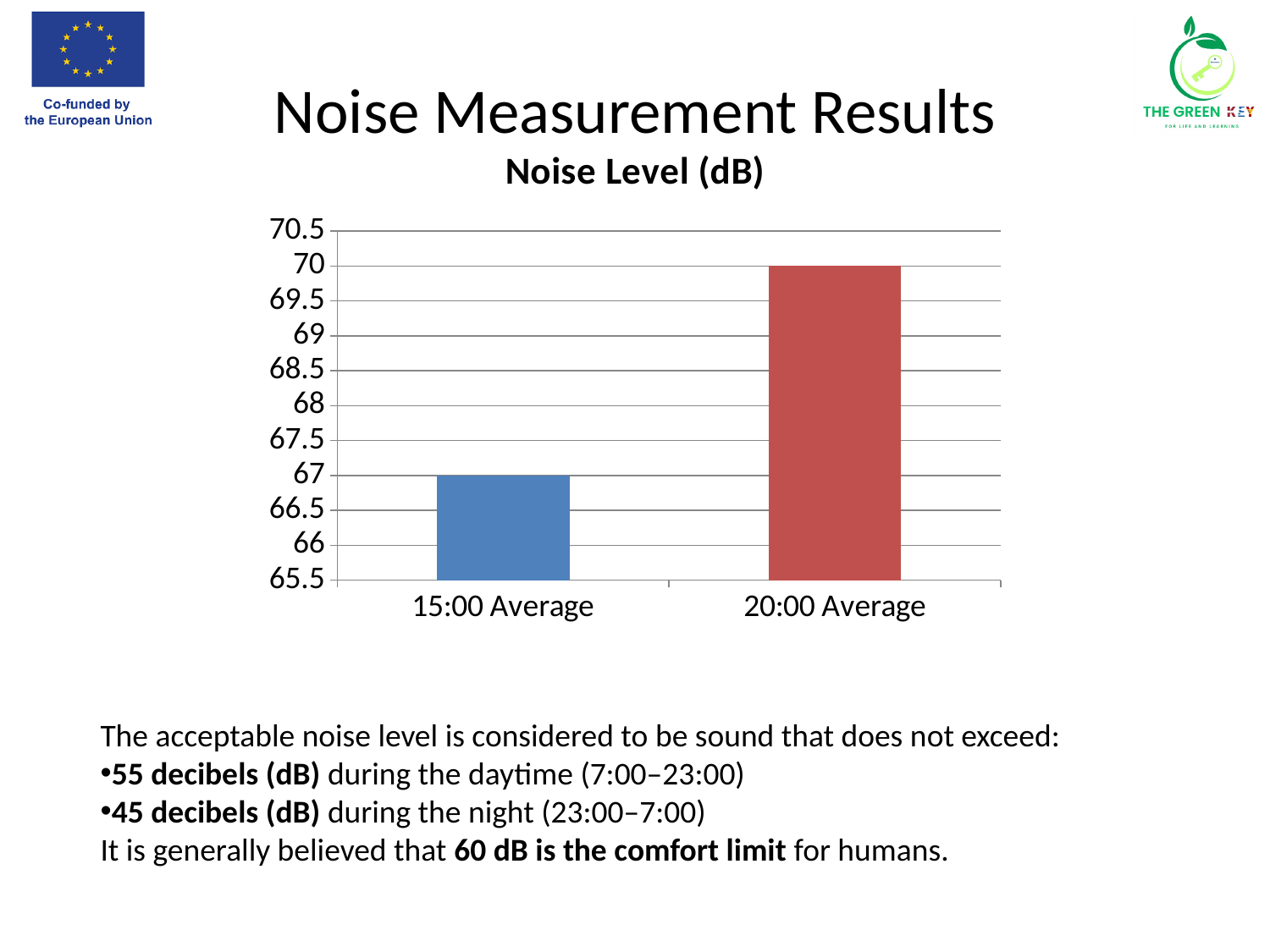
What is the difference in noise level between 20:00 Average and 15:00 Average? 3 What is the noise level for 20:00 Average? 70 What is the title of the chart? Noise Level (dB) Which category has the highest noise level? 20:00 Average Which is larger, the noise level for 15:00 Average or for 20:00 Average? 20:00 Average What kind of chart is shown on the slide? bar chart What colour is the bar for 20:00 Average? red Is the value for 15:00 Average greater or less than 68? less Is the value for 20:00 Average greater or less than 69? greater Which category has the lowest noise level? 15:00 Average What is the noise level for 15:00 Average? 67 How many categories are shown on the chart? 2